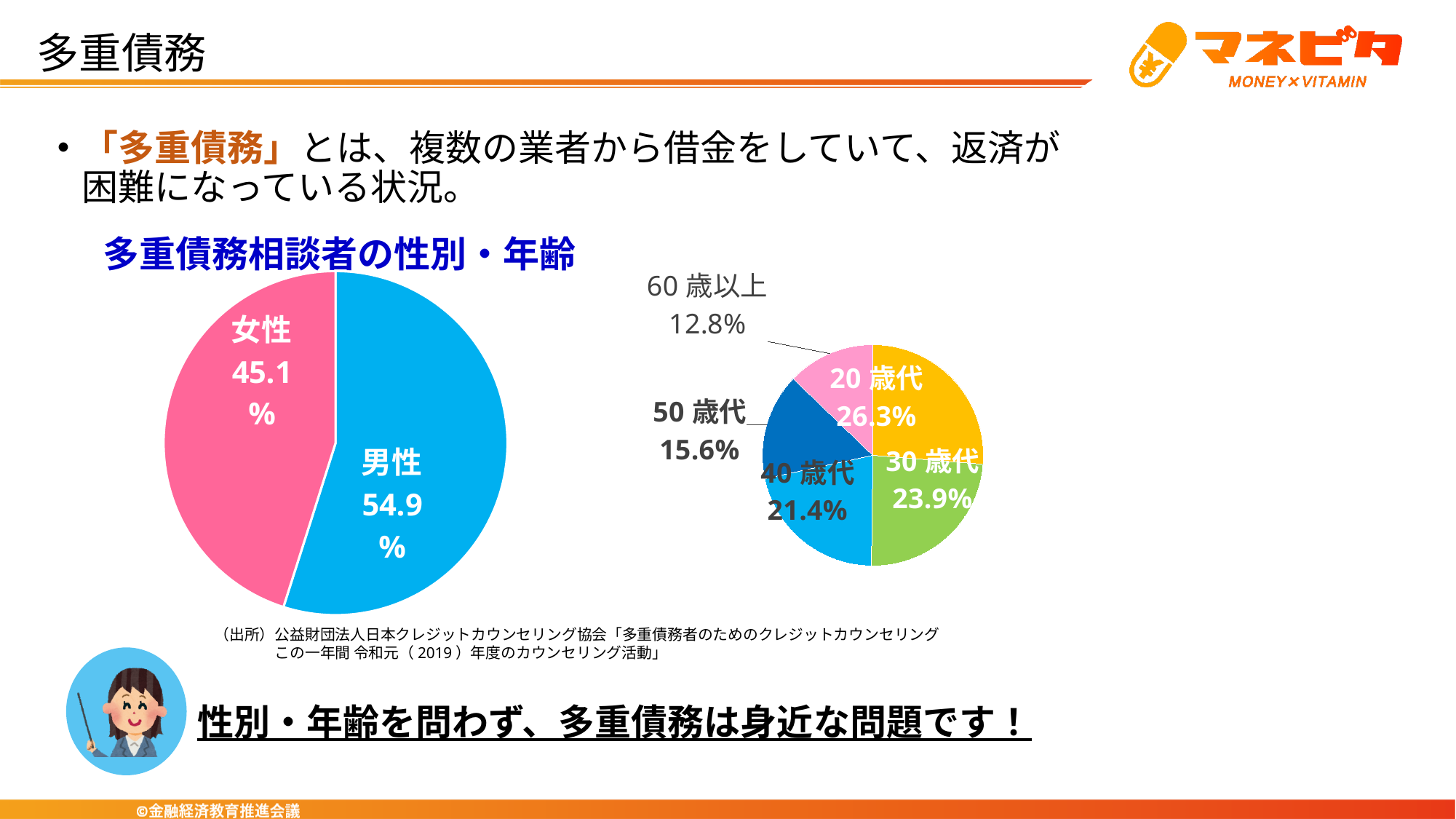
In the left pie chart (gender), what is the difference between the 男性 and 女性 shares? 9.8% In the right pie chart (age), what is the share for 60 歳以上? 12.8% In the left pie chart (gender), which slice is larger, 男性 or 女性? 男性 In the left pie chart (gender), what is the share for 男性? 54.9% In the right pie chart (age), what is the share for 20 歳代? 26.3% In the right pie chart (age), which age group has the smallest share? 60 歳以上 What type of chart is used for the left chart showing gender? Pie chart In the right pie chart (age), which age group has the largest share? 20 歳代 In the left pie chart (gender), what is the share for 女性? 45.1% In the right pie chart (age), what is the difference between the 30 歳代 and 50 歳代 shares? 8.3% In the right pie chart (age), how many age groups are shown? 5 In the right pie chart (age), what is the share for 40 歳代? 21.4%